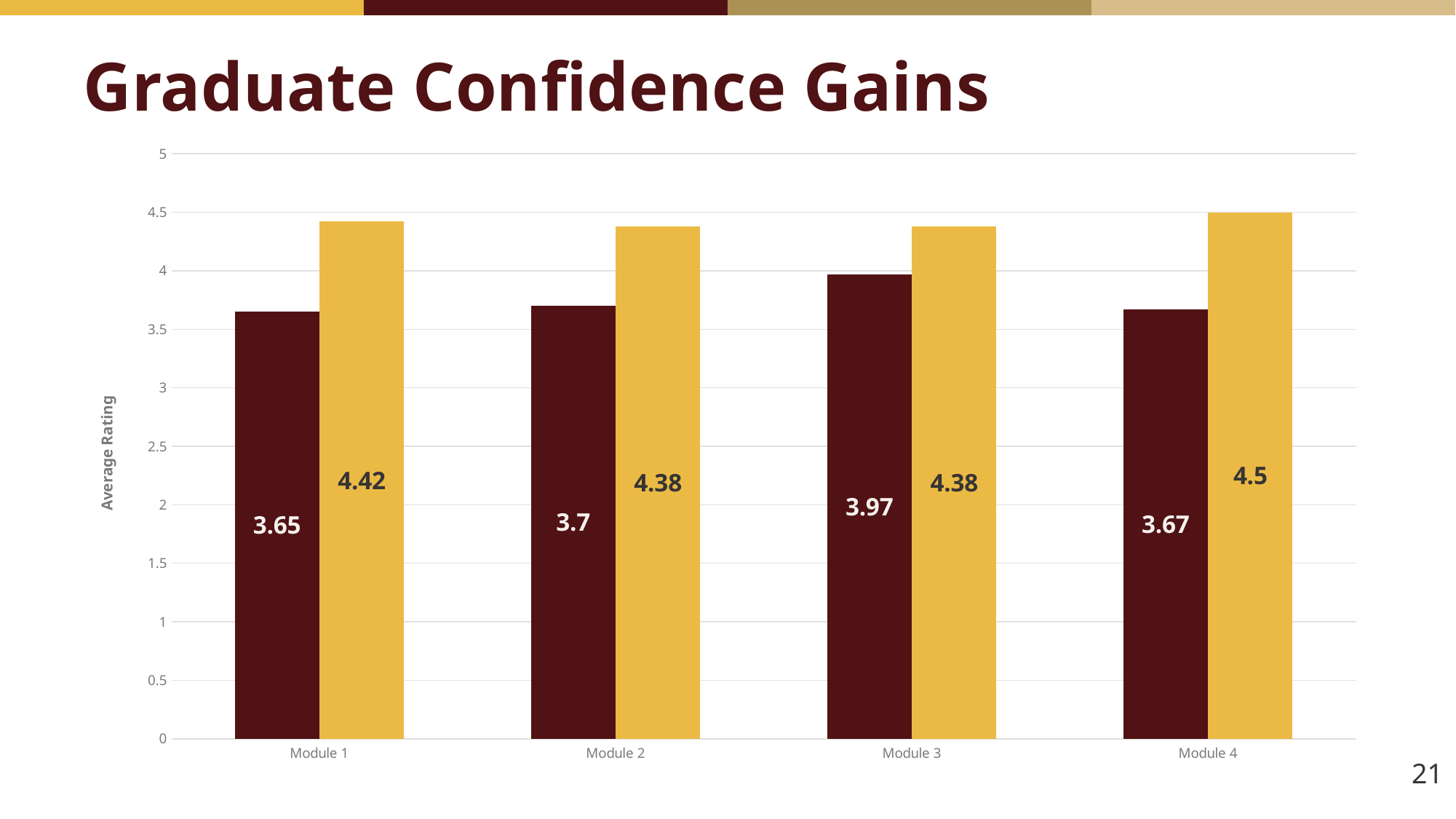
How many modules are shown on the x axis? 4 What is the difference between the gold bar and the dark red bar for Module 1? 0.77 What is the difference between the gold bar and the dark red bar for Module 4? 0.83 Which module has the highest dark red bar? Module 3 What is the value of the gold bar for Module 1? 4.42 What is the value of the dark red bar for Module 3? 3.97 Which module has the highest gold bar? Module 4 Which is larger: the dark red bar for Module 2 or the dark red bar for Module 3? Module 3 What is the title of the y axis? Average Rating Is the value of the dark red bar for Module 2 greater or less than 4? less Which module has the lowest dark red bar? Module 1 What is the value of the gold bar for Module 4? 4.5